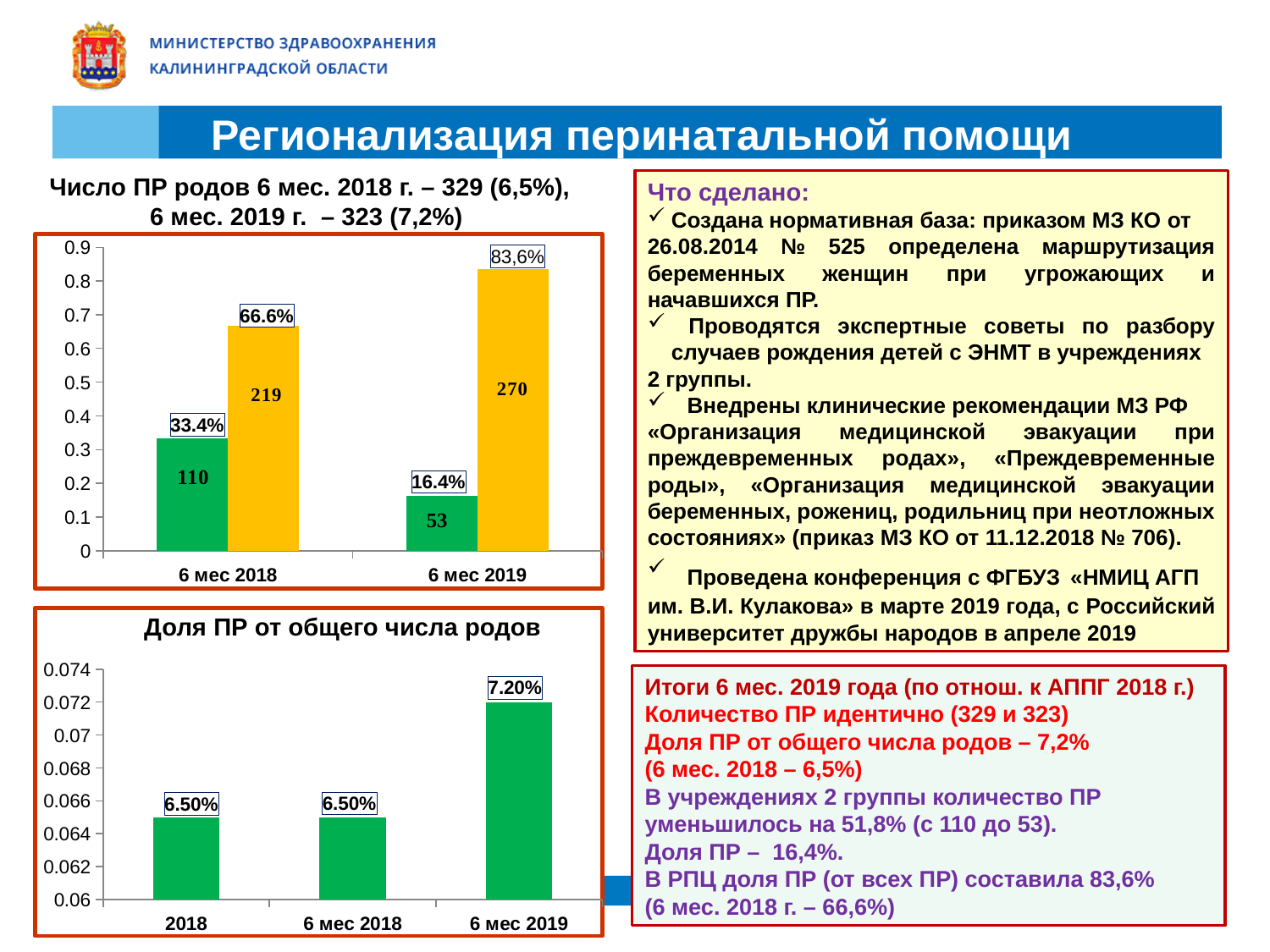
In the top chart, is the green bar for 6 мес 2019 greater or less than 0.2? less In the chart titled 'Доля ПР от общего числа родов', which category has the highest value? 6 мес 2019 In the top chart, what percentage label is shown on the yellow bar for 6 мес 2019? 83,6% In the top chart, which bar is taller for 6 мес 2019, the green bar or the yellow bar? the yellow bar In the chart titled 'Доля ПР от общего числа родов', how many bars are shown? 3 In the chart titled 'Доля ПР от общего числа родов', what is the value for 2018? 6.50% What type of chart is the chart titled 'Доля ПР от общего числа родов'? bar chart In the top chart, what number is printed inside the green bar for 6 мес 2019? 53 In the top chart, what number is printed inside the yellow bar for 6 мес 2018? 219 In the chart titled 'Доля ПР от общего числа родов', what is the value for 6 мес 2019? 7.20% In the top chart, what percentage label is shown on the green bar for 6 мес 2018? 33.4% In the top chart, how many categories are shown on the x axis? 2